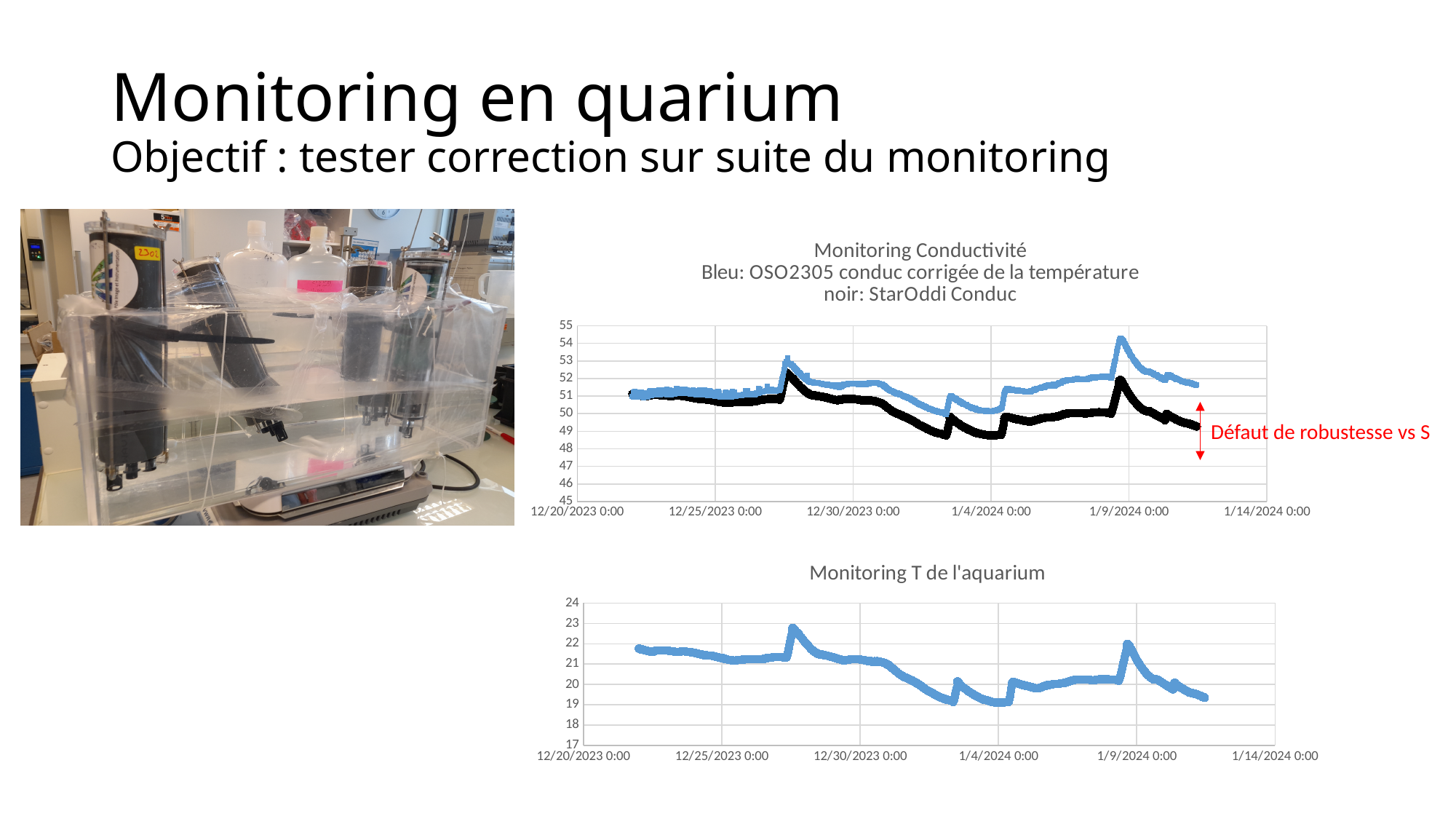
In the 'Monitoring Conductivité' chart, which line is higher at the end of the series, the blue line or the black line? the blue line In the 'Monitoring Conductivité' chart, does the black line overall rise or fall from the start to the end of the period? fall In the 'Monitoring Conductivité' chart, is the lowest value of the black line around 1/3/2024 greater or less than 49? less In the 'Monitoring T de l'aquarium' chart, does the temperature overall rise or fall from the start to the end of the period? fall In the 'Monitoring Conductivité' chart, which sensor does the blue line represent according to the title? OSO2305 conduc corrigée de la température In the 'Monitoring T de l'aquarium' chart, is the peak value around 12/27/2023 greater or less than 22? greater In the 'Monitoring Conductivité' chart, is the peak value of the black line around 12/27/2023 greater or less than 52? greater In the 'Monitoring Conductivité' chart, how many series are plotted? 2 What kind of chart is the 'Monitoring T de l'aquarium' chart? line chart What kind of chart is the 'Monitoring Conductivité' chart? line chart In the 'Monitoring Conductivité' chart, which sensor does the black line represent according to the title? StarOddi Conduc